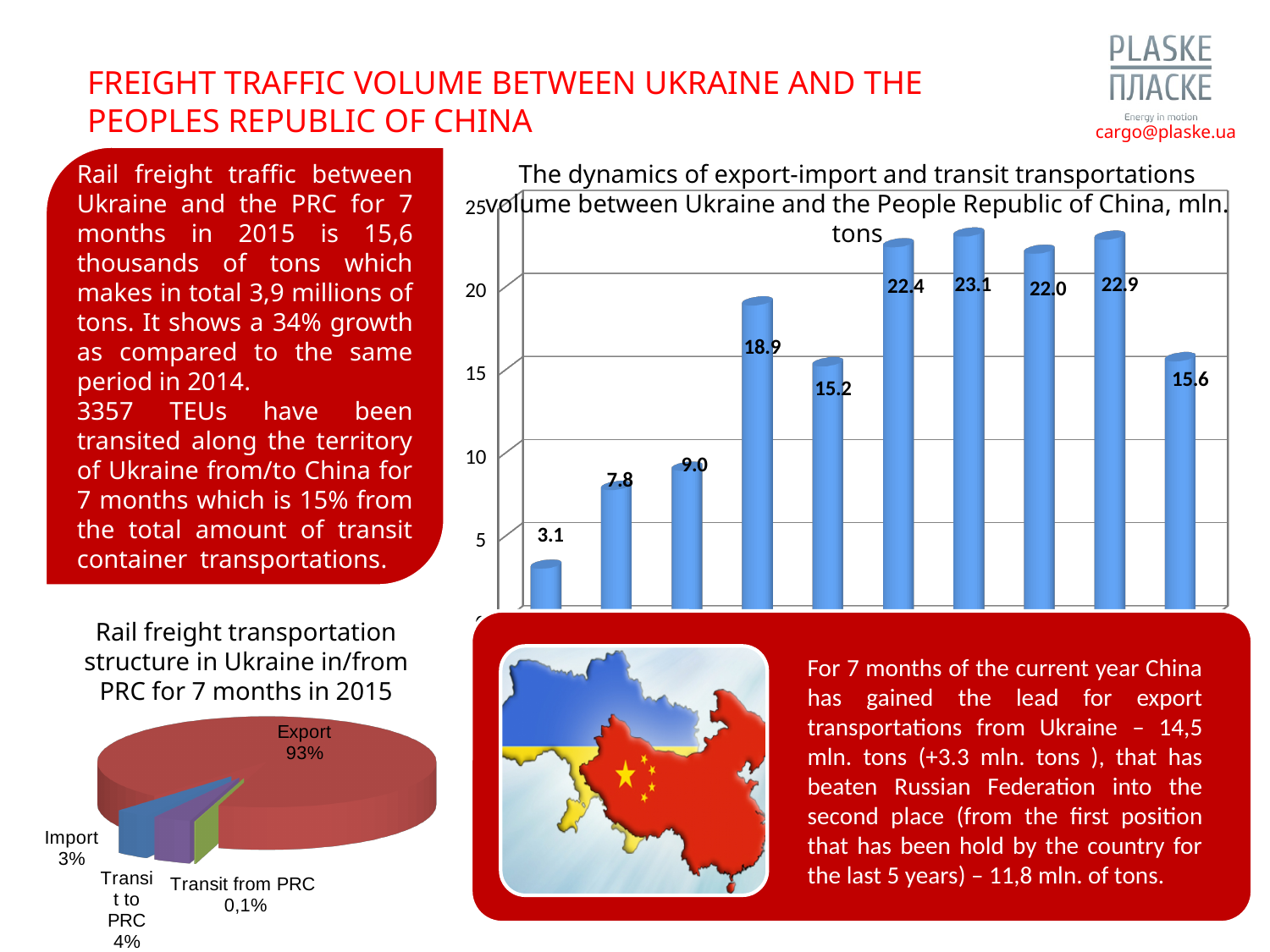
In the bar chart 'The dynamics of export-import and transit transportations volume', what is the value of the leftmost bar? 3.1 In the pie chart 'Rail freight transportation structure in Ukraine in/from PRC for 7 months in 2015', what share does Export have? 93% In the bar chart 'The dynamics of export-import and transit transportations volume', which is larger: the bar labelled 18.9 or the bar labelled 15.2? 18.9 In the bar chart 'The dynamics of export-import and transit transportations volume', what is the highest value shown? 23.1 In the pie chart 'Rail freight transportation structure in Ukraine in/from PRC for 7 months in 2015', which is larger: Import or Transit to PRC? Transit to PRC In the bar chart 'The dynamics of export-import and transit transportations volume', what unit is stated in the chart title? mln. tons In the pie chart 'Rail freight transportation structure in Ukraine in/from PRC for 7 months in 2015', what share does Transit from PRC have? 0,1% What type of chart is the chart titled 'The dynamics of export-import and transit transportations volume between Ukraine and the People Republic of China'? Bar chart In the bar chart 'The dynamics of export-import and transit transportations volume', how many bars are plotted? 10 In the bar chart 'The dynamics of export-import and transit transportations volume', what is the value of the rightmost bar? 15.6 In the bar chart 'The dynamics of export-import and transit transportations volume', what is the lowest value shown? 3.1 In the bar chart 'The dynamics of export-import and transit transportations volume', what is the difference between the highest bar (23.1) and the lowest bar (3.1)? 20.0